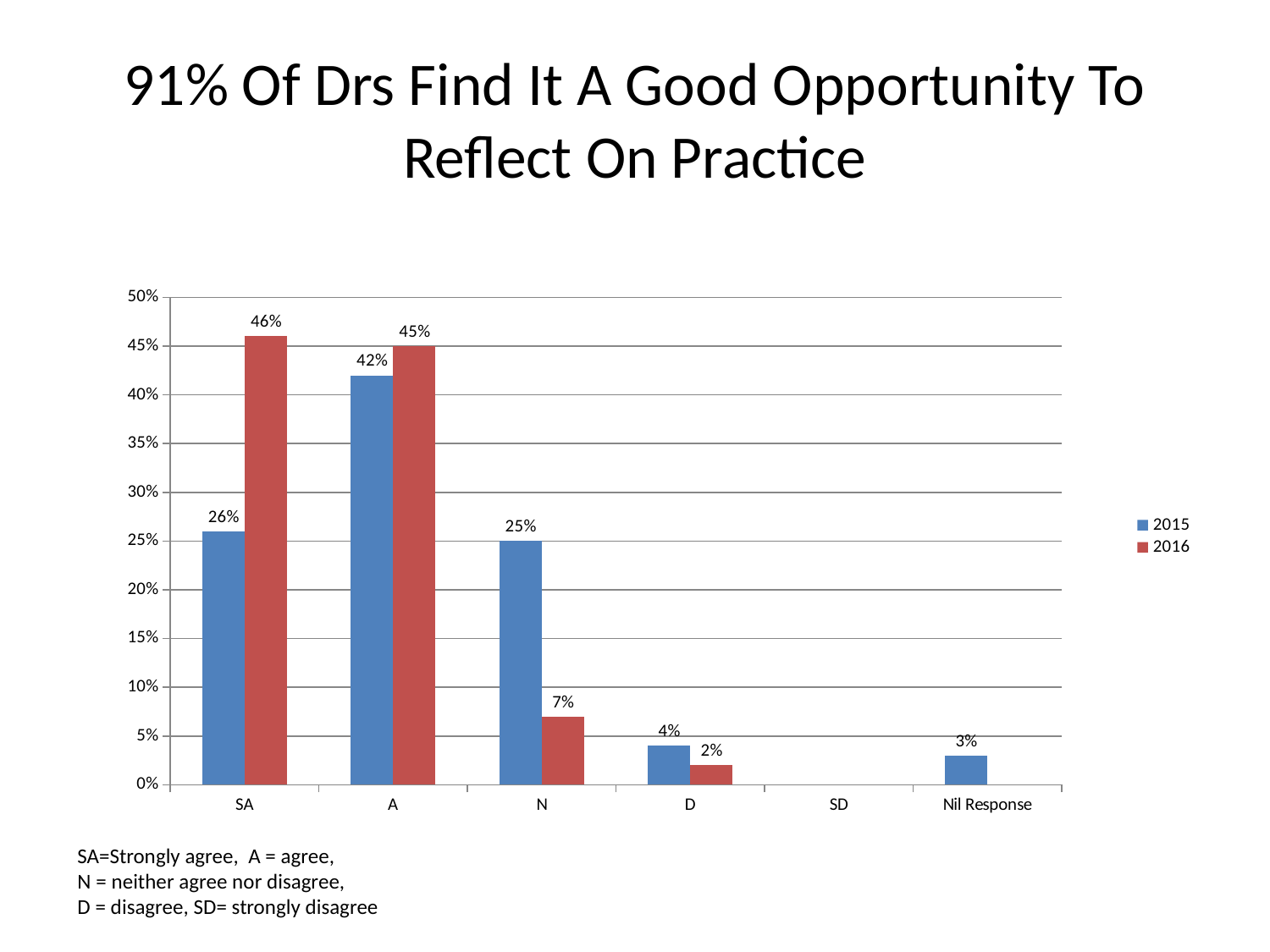
What is the 2016 value for SA? 46% What is the 2015 value for N? 25% How many series does the legend list? 2 Which colour represents the 2016 series? Red Which is larger for D, the 2015 value or the 2016 value? 2015 What is the difference between the 2015 and 2016 values for N? 18% Which category has the highest 2016 value? SA What is the 2015 value for Nil Response? 3% How many categories are shown on the x axis? 6 What is the difference between the 2016 and 2015 values for SA? 20% Which category has the highest 2015 value? A What kind of chart is shown on the slide? Bar chart